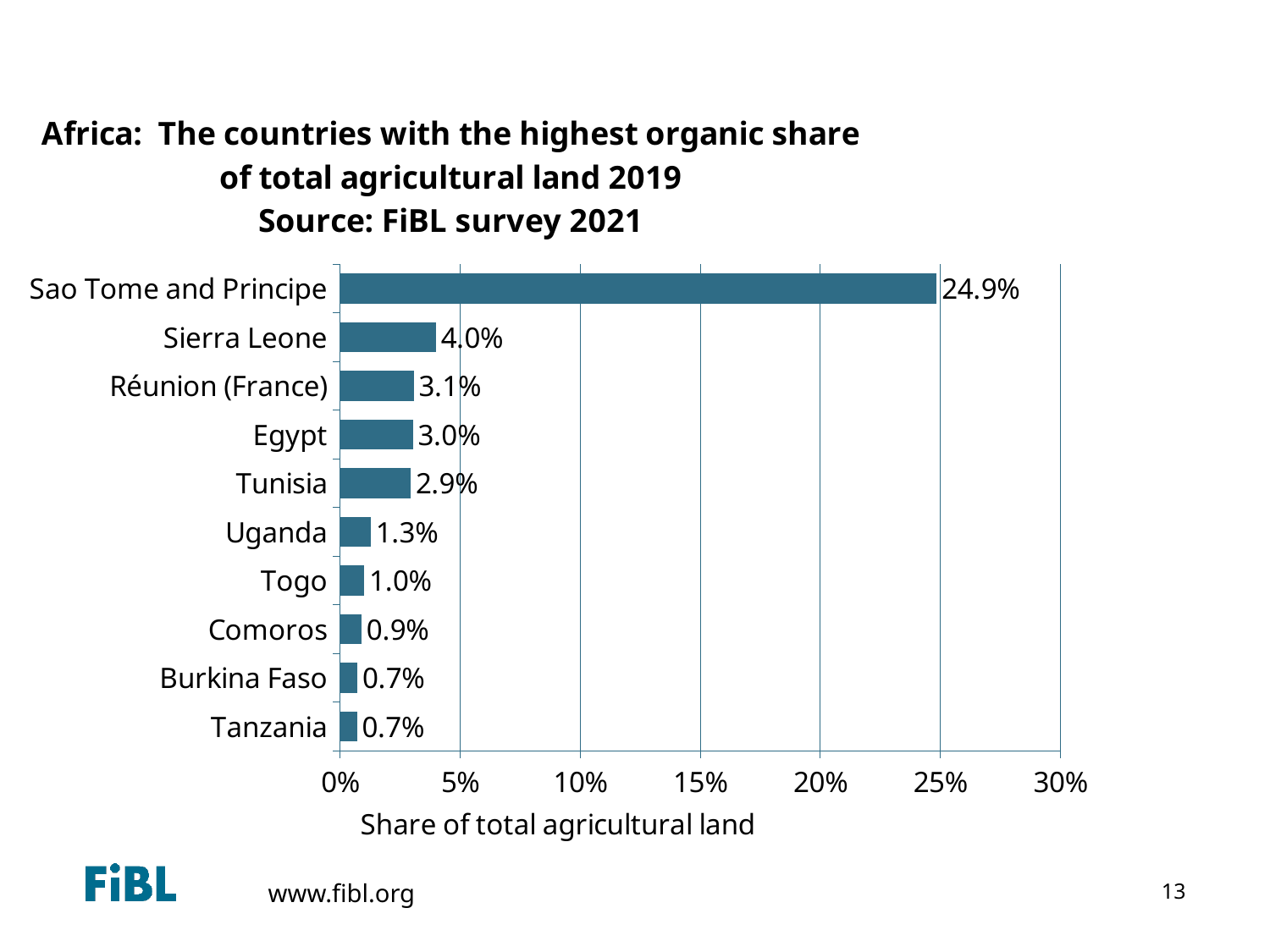
What is the source given in the chart title? FiBL survey 2021 Which has a larger organic share of agricultural land, Réunion (France) or Togo? Réunion (France) What is the organic share of total agricultural land for Uganda? 1.3% What is the difference between the organic share of Sierra Leone and Tunisia? 1.1% What is the organic share of total agricultural land for Comoros? 0.9% What is the organic share of total agricultural land for Sao Tome and Principe? 24.9% How many countries are shown in the chart? 10 What kind of chart is shown on the slide? Bar chart Is the value for Sao Tome and Principe greater or less than 20%? greater What is the organic share of total agricultural land for Egypt? 3.0% What is the label of the horizontal axis? Share of total agricultural land Which country has the highest organic share of total agricultural land? Sao Tome and Principe